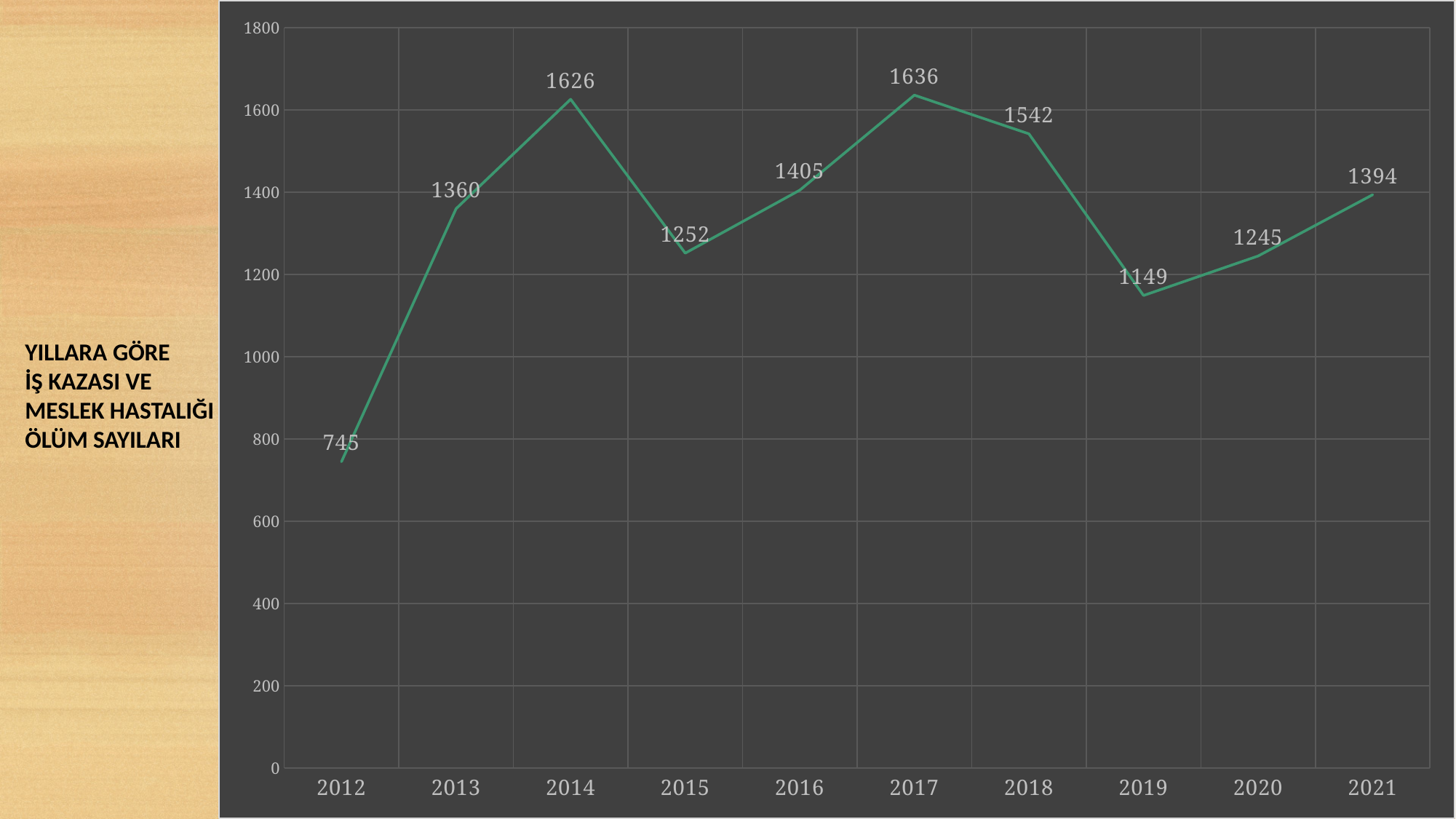
What is the difference between the values for 2018 and 2019? 393 Which year has the lowest value? 2012 Which is larger, the value for 2013 or the value for 2016? 2016 Is the value for 2015 greater or less than 1200? greater Do the values rise or fall from 2019 to 2021? rise What kind of chart is shown on the slide? line chart What is the value for 2021? 1394 What is the difference between the values for 2017 and 2012? 891 How many years are shown on the x axis? 10 What is the value for 2014? 1626 Which year has the highest value? 2017 What is the value for 2019? 1149